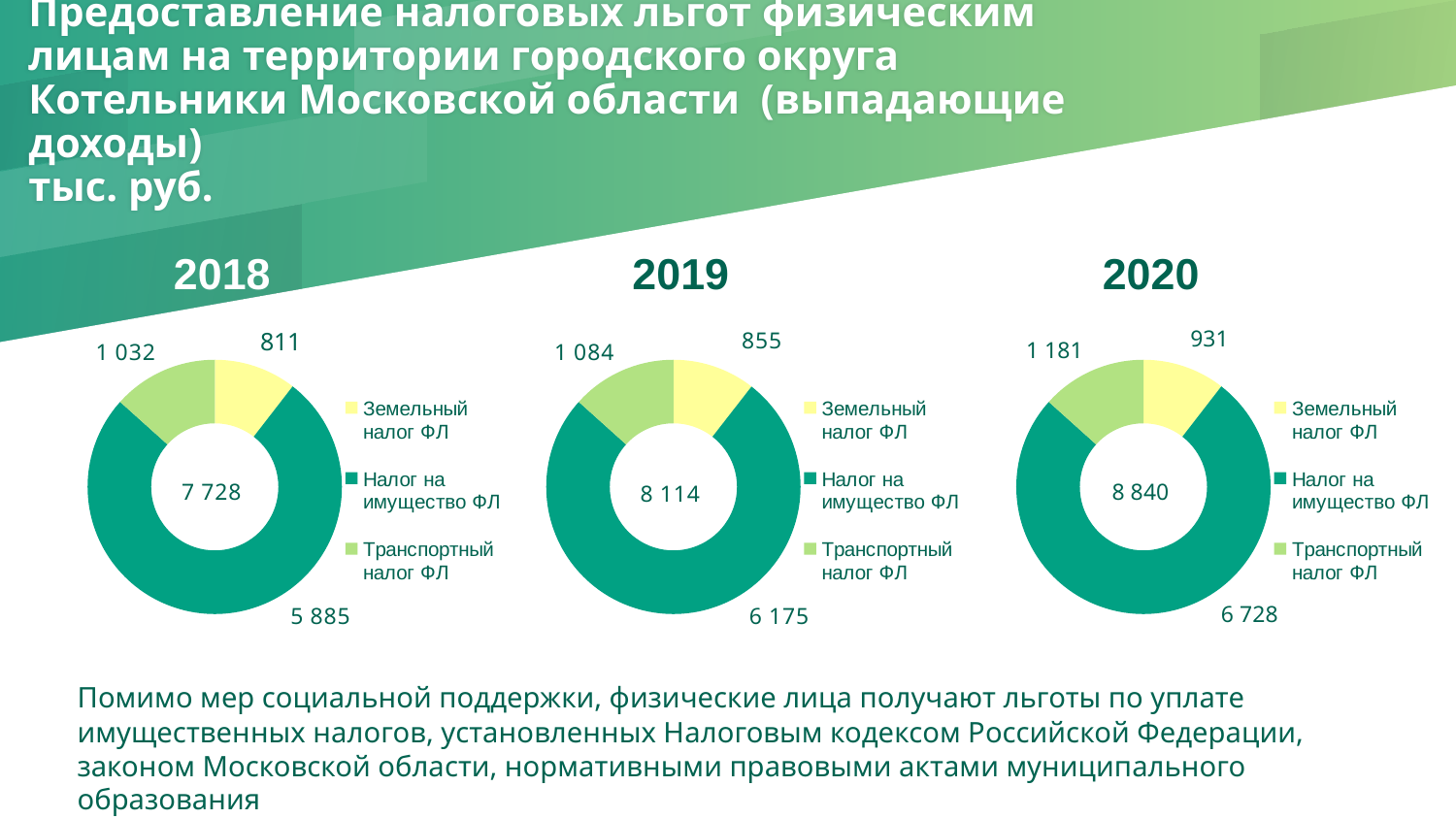
In the 2018 chart, what is the value for Налог на имущество ФЛ? 5 885 In the 2020 chart, what is the value for Транспортный налог ФЛ? 1 181 What total is shown in the centre of the 2019 chart? 8 114 In the 2019 chart, what is the value for Земельный налог ФЛ? 855 What kind of chart is used for the 2018 data? Pie (donut) chart In the 2019 chart, what is the difference between Транспортный налог ФЛ and Земельный налог ФЛ? 229 In the 2020 chart, which is larger: Транспортный налог ФЛ or Земельный налог ФЛ? Транспортный налог ФЛ How many charts are on the slide? 3 In the 2020 chart, which category has the largest value? Налог на имущество ФЛ Which colour represents Земельный налог ФЛ in the legend? Yellow How many categories does each chart show? 3 In the 2018 chart, which category has the smallest value? Земельный налог ФЛ